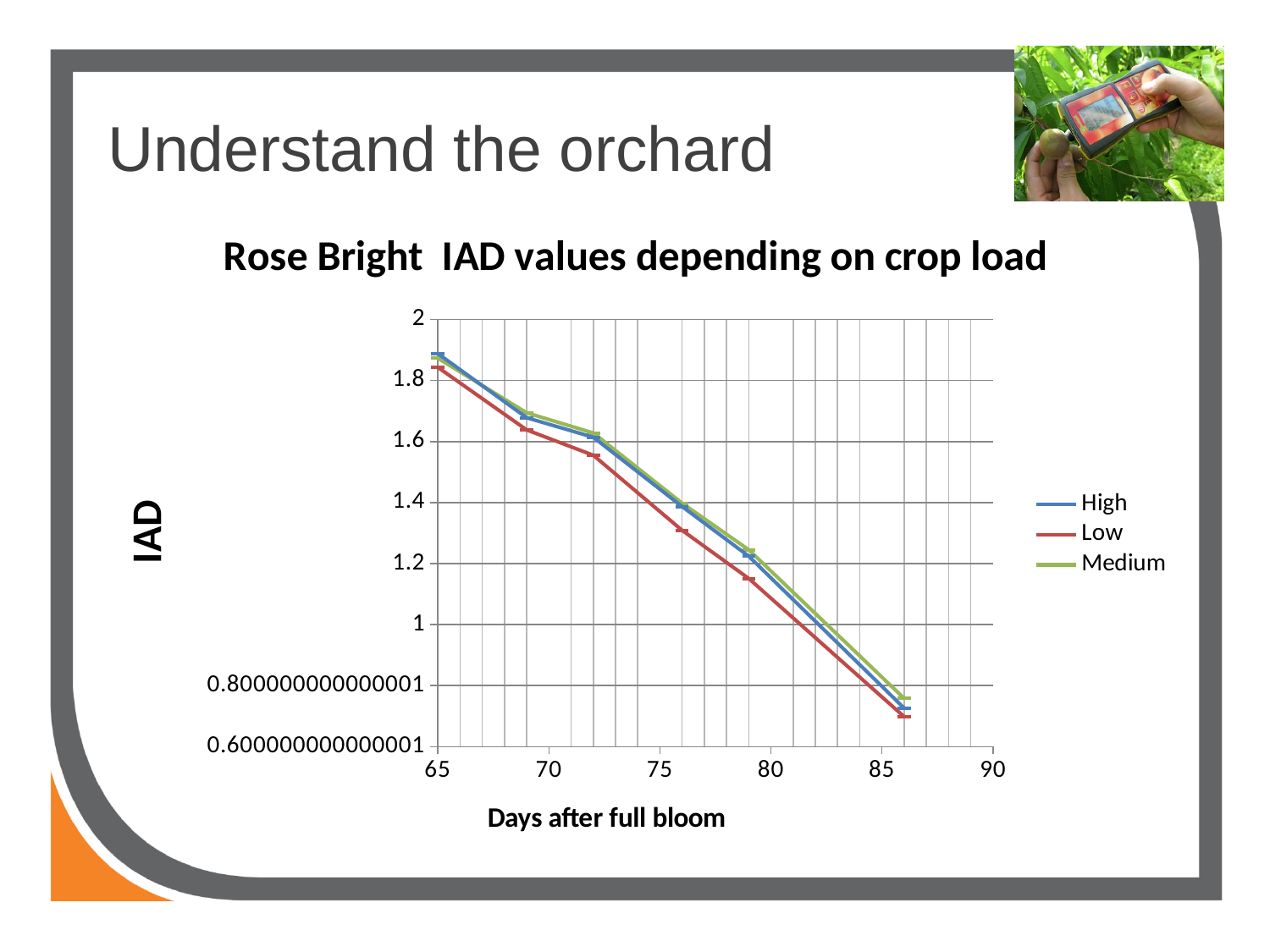
What is the title of the chart? Rose Bright IAD values depending on crop load Which series has the lowest IAD value at day 79? Low Is the IAD value for the Low series at day 72 greater or less than 1.6? less How many series does the legend list? 3 Do the IAD values rise or fall as days after full bloom increase? Fall Is the IAD value for the High series at day 65 greater or less than 1.8? greater How many data points are plotted for the Low series? 6 Is the IAD value for the Low series at day 86 greater or less than 0.8? less At day 76, which series has the larger IAD value, Low or Medium? Medium What kind of chart is shown on the slide? Line chart What is the label of the x axis? Days after full bloom